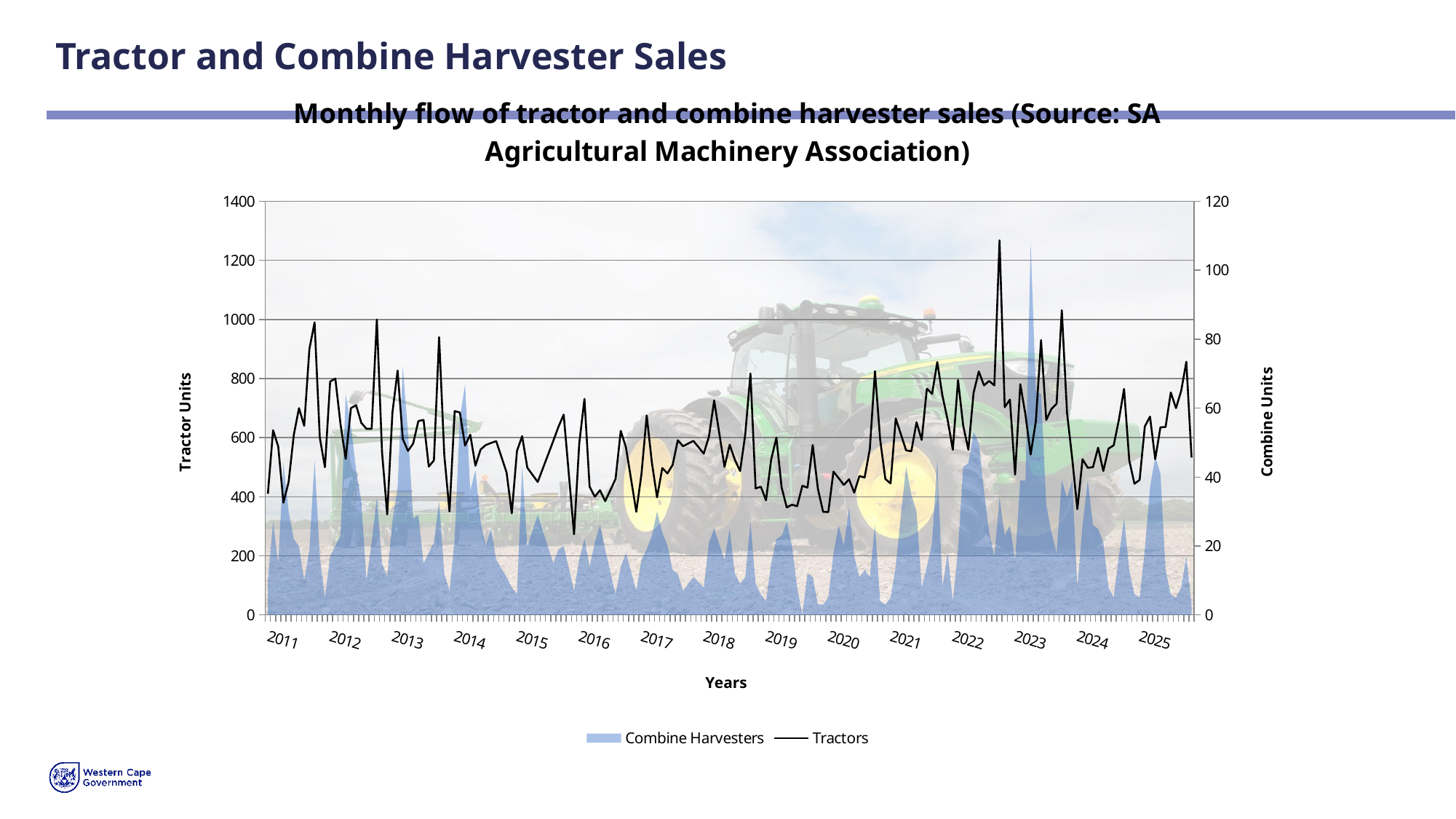
How many series does the legend list? 2 How many year labels are shown on the x axis? 15 Is the peak of the Combine Harvesters series in 2023 greater or less than 80 combine units? greater What is the title of the chart? Monthly flow of tractor and combine harvester sales (Source: SA Agricultural Machinery Association) Is the peak value of the Tractors line in 2022 greater or less than 1200? greater Is the lowest value of the Tractors line around 2016 greater or less than 400? less Does the Tractors line generally rise or fall between 2019 and 2022? rise In which year does the Tractors line reach its highest peak? 2022 What is the highest value shown on the right (Combine Units) axis? 120 What kind of chart is used to plot the Tractors series? Line chart What are the two series named in the legend? Combine Harvesters and Tractors What is the highest value shown on the left (Tractor Units) axis? 1400